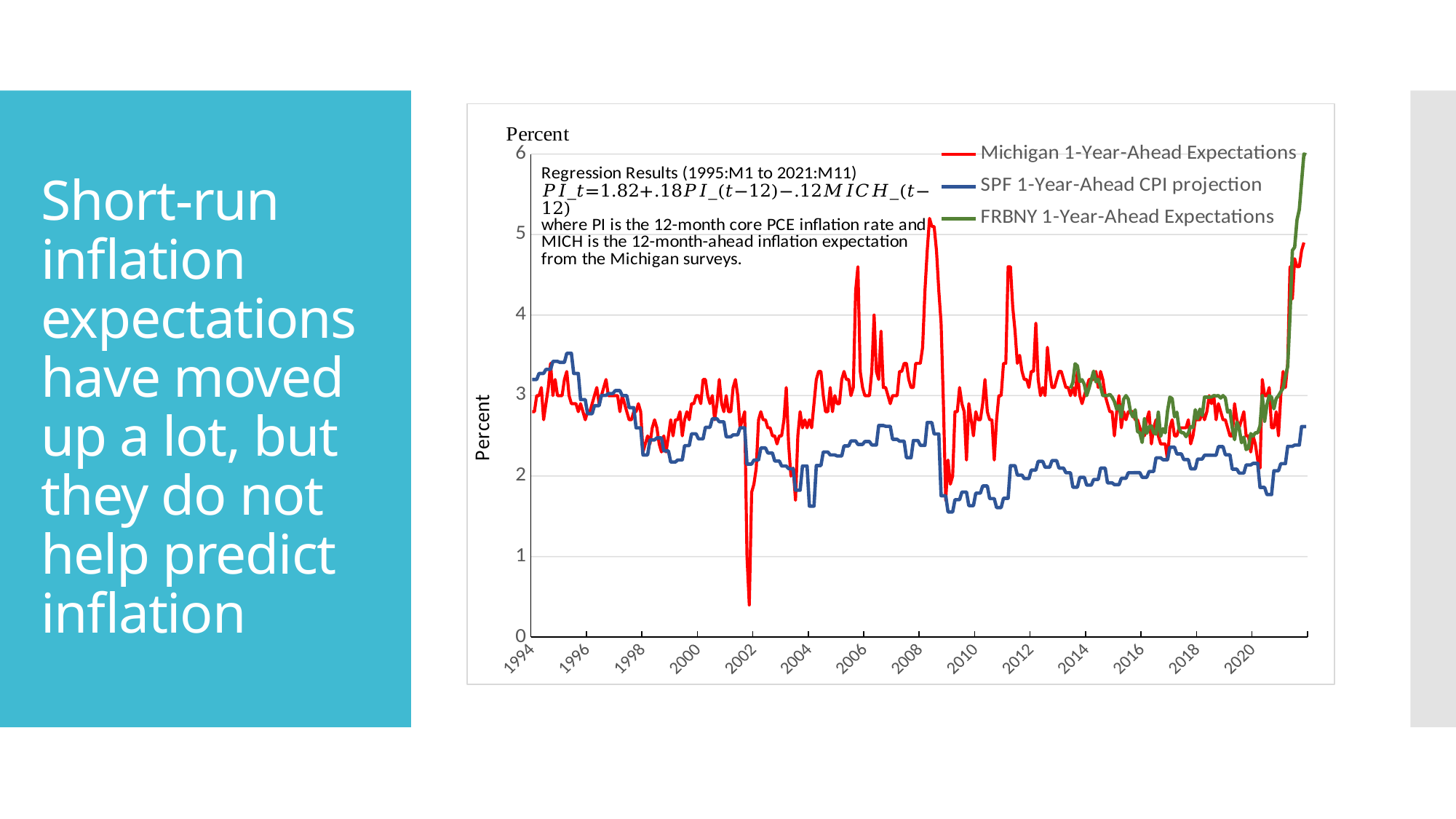
Is the final value of the FRBNY 1-Year-Ahead Expectations series at the right end of the chart greater or less than 5? greater What kind of chart is shown on the slide? line chart What are the three series listed in the chart's legend? Michigan 1-Year-Ahead Expectations, SPF 1-Year-Ahead CPI projection, FRBNY 1-Year-Ahead Expectations Is the peak of the Michigan 1-Year-Ahead Expectations series around 2008 greater or less than 4? greater Does the SPF 1-Year-Ahead CPI projection rise or fall from 2020 to the end of the chart? rise How many series does the chart's legend list? 3 Which series reaches the highest value anywhere on the chart? FRBNY 1-Year-Ahead Expectations Is the SPF 1-Year-Ahead CPI projection around 2009 greater or less than 2? less At the right end of the chart, which series is higher: FRBNY 1-Year-Ahead Expectations or SPF 1-Year-Ahead CPI projection? FRBNY 1-Year-Ahead Expectations Which series is drawn in red on the chart? Michigan 1-Year-Ahead Expectations How many year labels are shown on the chart's x axis? 14